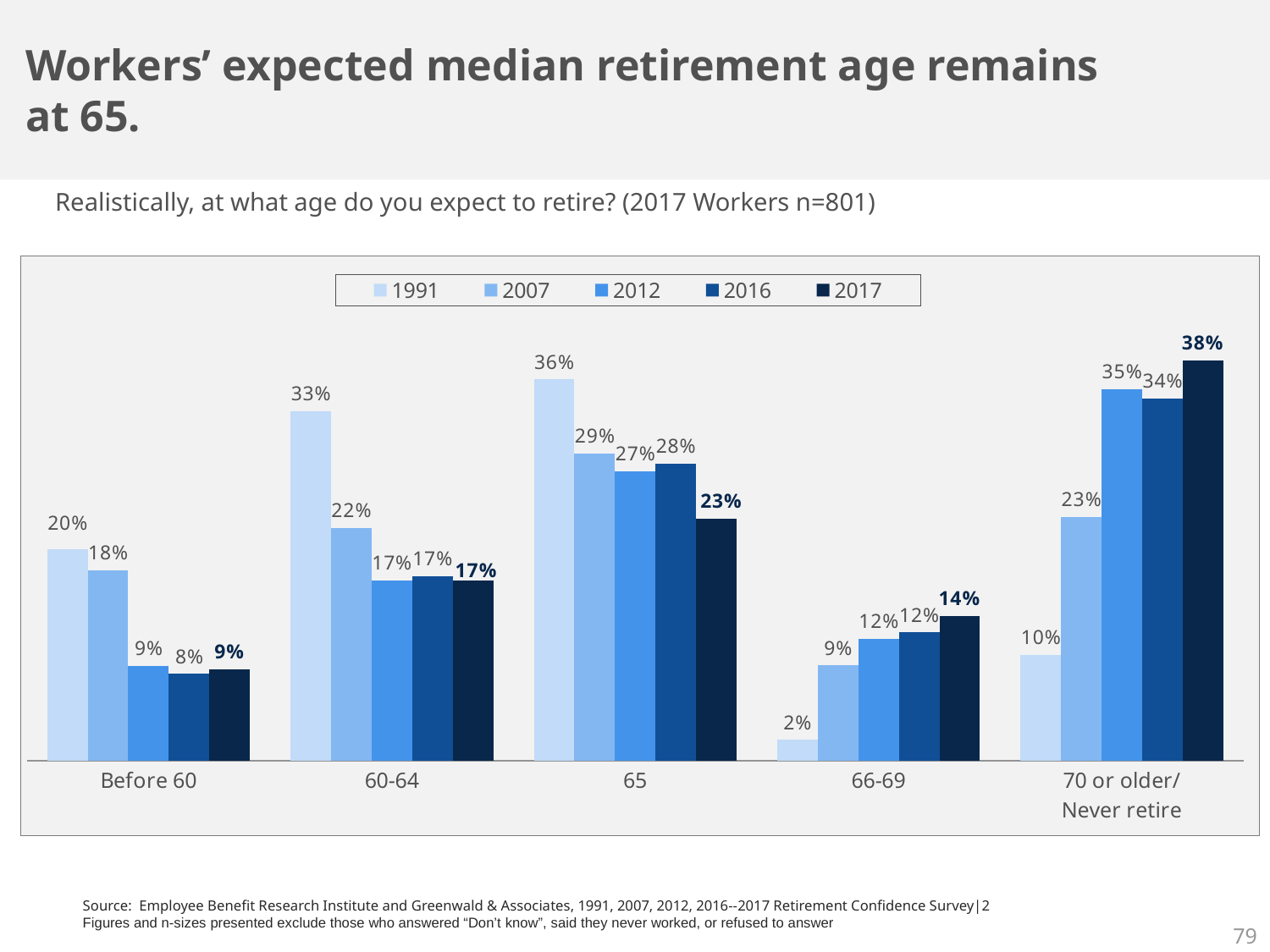
How many series does the legend list? 5 Which category has the lowest 1991 value? 66-69 Which category has the highest 2017 value? 70 or older/Never retire Across the years 1991 to 2017, do the values for '70 or older/Never retire' generally rise or fall? Rise What is the 2012 value for '70 or older/Never retire'? 35% What is the 2017 value for the '65' category? 23% What kind of chart is shown on the slide? Bar chart What is the difference between the 1991 and 2017 values for '65'? 13% What is the 1991 value for 'Before 60'? 20% How many categories are shown on the x axis? 5 Which is larger for '60-64': the 1991 value or the 2007 value? 1991 What is the 1991 value for '66-69'? 2%